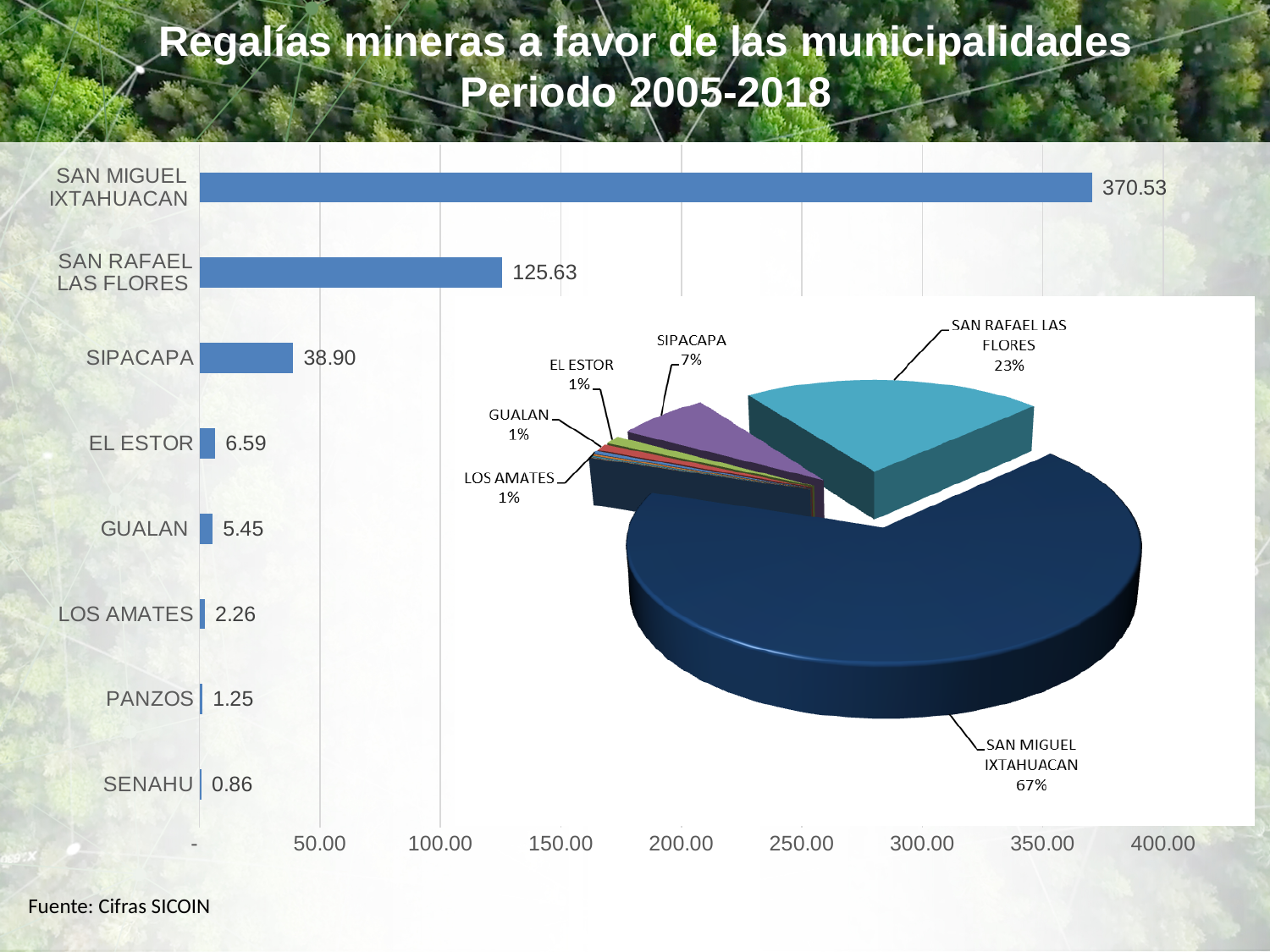
In the bar chart, what is the value for SENAHU? 0.86 In the bar chart, what is the difference between the values for SAN MIGUEL IXTAHUACAN and SAN RAFAEL LAS FLORES? 244.90 How many municipalities are shown in the bar chart? 8 What kind of chart is the chart on the left of the slide? bar chart In the pie chart, what share does SAN RAFAEL LAS FLORES have? 23% In the bar chart, is the value for SAN MIGUEL IXTAHUACAN greater or less than 350.00? greater In the bar chart, which municipality has the highest value? SAN MIGUEL IXTAHUACAN In the bar chart, what is the value for SIPACAPA? 38.90 In the bar chart, which municipality has the lowest value? SENAHU In the bar chart, what is the value for SAN RAFAEL LAS FLORES? 125.63 In the pie chart, what share does SAN MIGUEL IXTAHUACAN have? 67% In the bar chart, which is larger, the value for EL ESTOR or the value for GUALAN? EL ESTOR